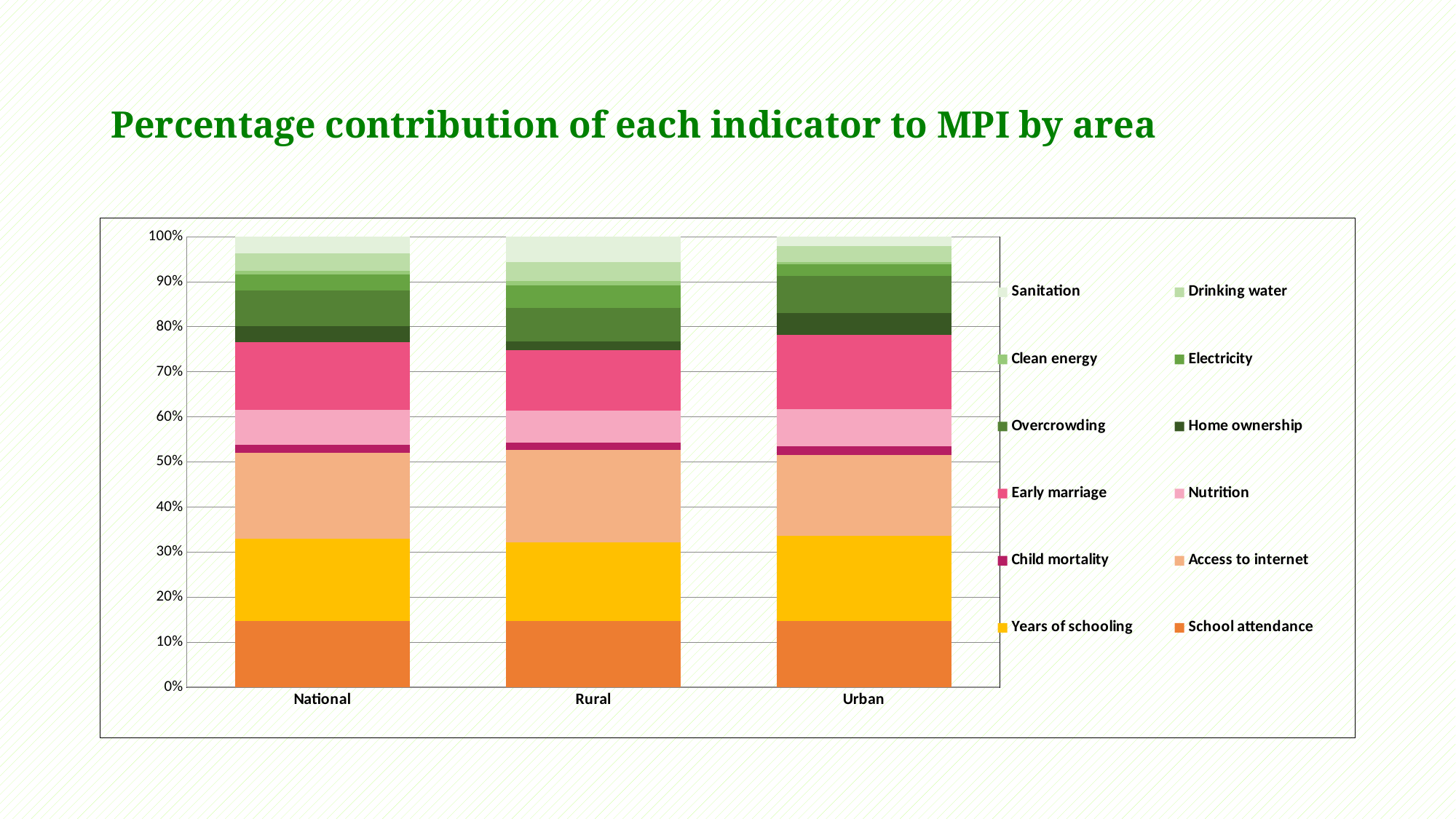
Is the Access to internet contribution for Urban greater or less than 10%? greater Is the Sanitation contribution for Urban greater or less than 10%? less What kind of chart is shown on the slide? Stacked bar chart Which area has the larger Home ownership contribution, Rural or Urban? Urban Which area has the larger Drinking water contribution, Rural or Urban? Rural Which indicator forms the bottom segment of each bar? School attendance Is the Child mortality contribution for Rural greater or less than 10%? less How many indicators does the legend list? 12 How many areas (categories) are shown on the x axis? 3 What is the title of the chart? Percentage contribution of each indicator to MPI by area What is the total height of the National stacked bar? 100%